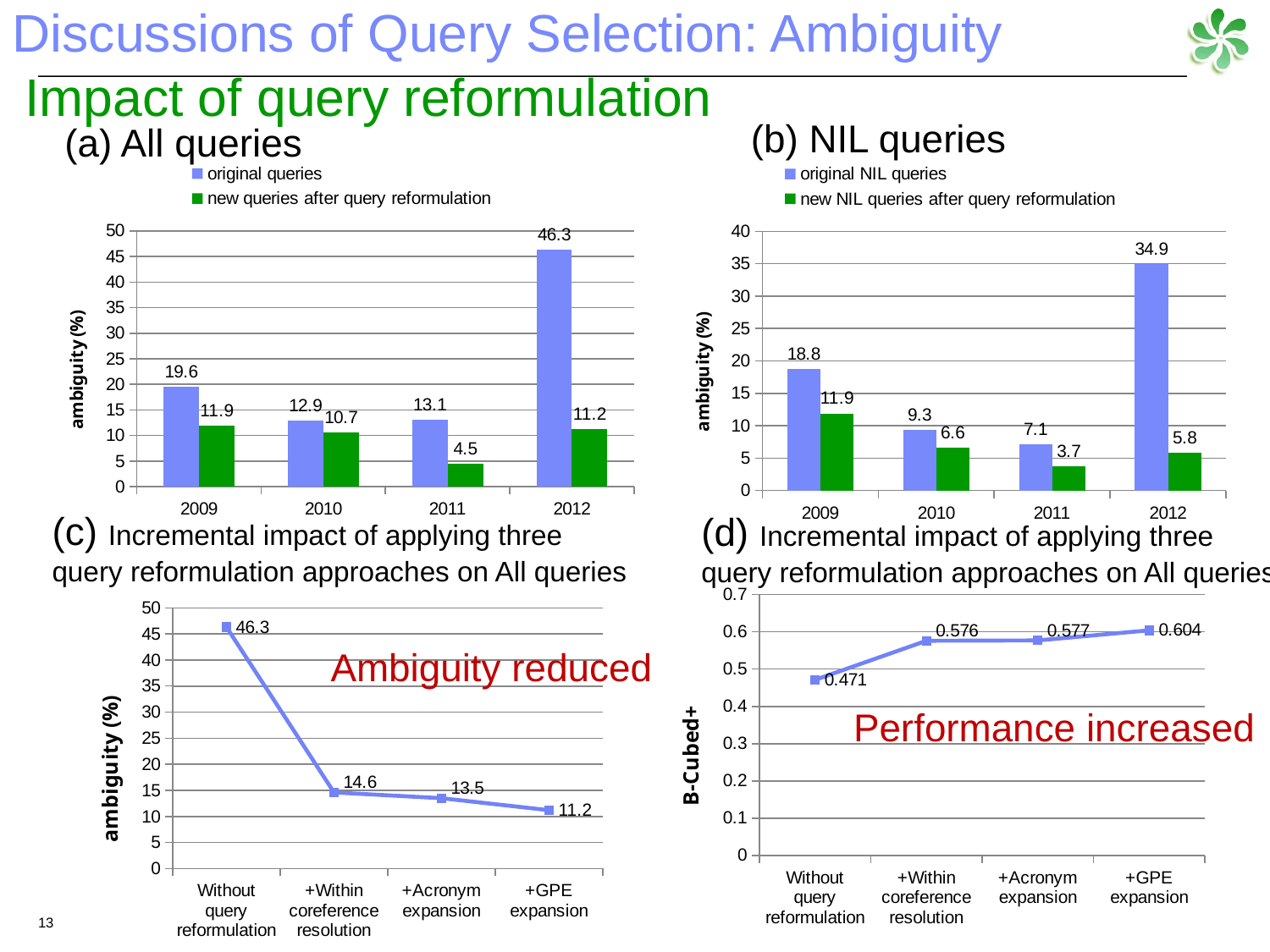
In chart (b) NIL queries, which year has the lowest value for new NIL queries after query reformulation? 2011 In chart (c), do the values rise or fall from left to right along the x axis? fall In chart (a) All queries, what is the difference between original queries and new queries after query reformulation in 2009? 7.7 In chart (a) All queries, what is the ambiguity value for original queries in 2012? 46.3 In chart (b) NIL queries, what is the ambiguity value for original NIL queries in 2010? 9.3 In chart (d), what is the B-Cubed+ value for Without query reformulation? 0.471 In chart (a) All queries, what is the ambiguity value for new queries after query reformulation in 2011? 4.5 In chart (c), what is the ambiguity value after +Within coreference resolution? 14.6 In chart (b) NIL queries, what kind of chart is shown? bar chart In chart (d), how many data points are plotted? 4 In chart (a) All queries, how many series does the legend list? 2 In chart (b) NIL queries, which year has the highest value for original NIL queries? 2012